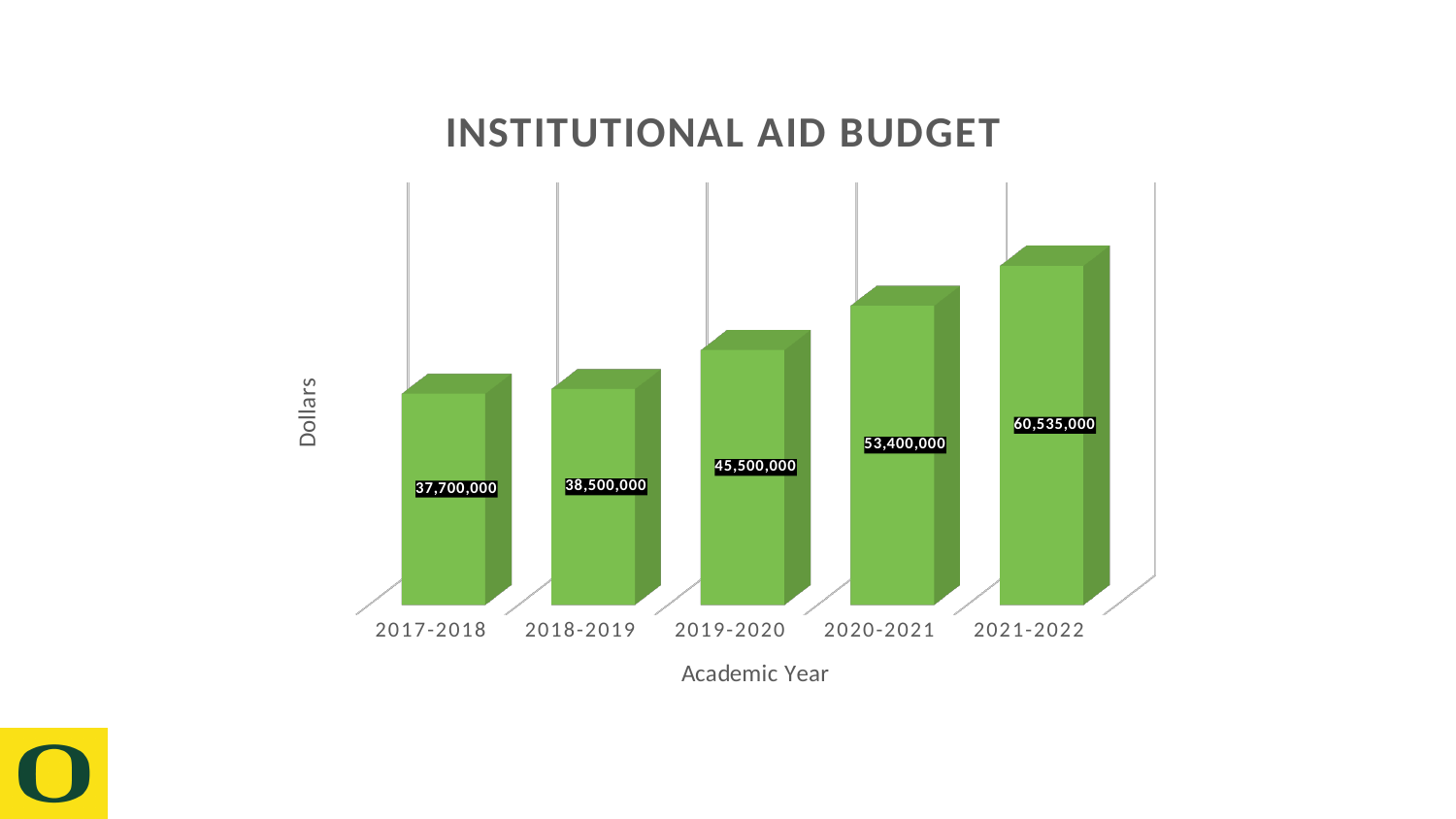
Which academic year has the highest institutional aid budget? 2021-2022 What is the difference between the 2020-2021 and 2019-2020 institutional aid budgets? 7,900,000 How many academic years are shown in the chart? 5 What is the institutional aid budget for 2021-2022? 60,535,000 What is the institutional aid budget for 2019-2020? 45,500,000 What kind of chart is shown on the slide? Bar chart What is the title of the chart? INSTITUTIONAL AID BUDGET What is the institutional aid budget for 2017-2018? 37,700,000 What is the difference between the 2018-2019 and 2017-2018 institutional aid budgets? 800,000 Which is larger, the budget for 2020-2021 or for 2018-2019? 2020-2021 Which academic year has the lowest institutional aid budget? 2017-2018 Do the institutional aid budget values rise or fall from 2017-2018 to 2021-2022? Rise